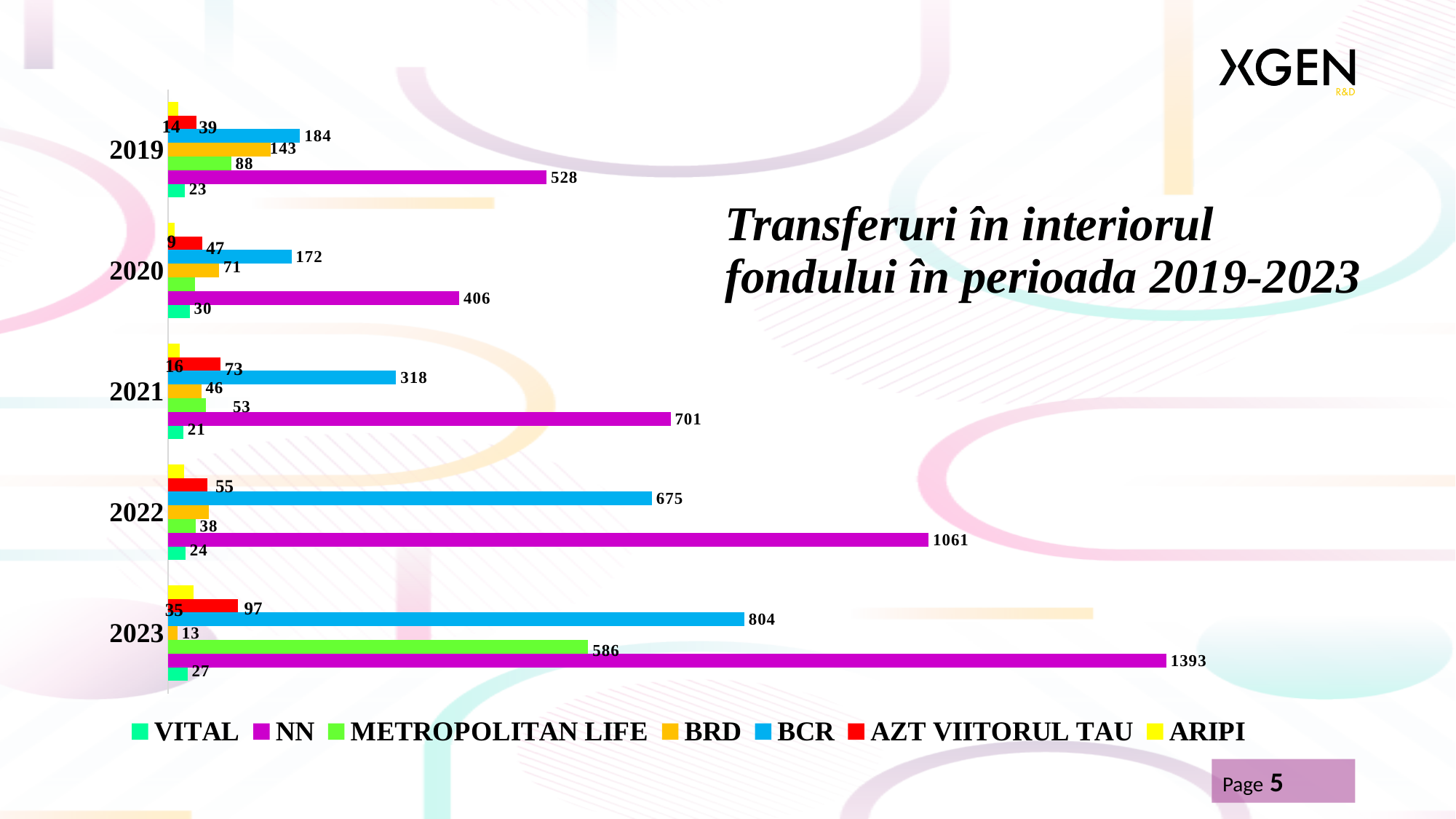
In which year is the NN value highest? 2023 What is the value for METROPOLITAN LIFE in 2023? 586 How many years are shown on the chart? 5 What is the value for NN in 2023? 1393 What is the value for VITAL in 2020? 30 What is the difference between the NN values for 2023 and 2022? 332 What is the value for BRD in 2019? 143 How many series does the legend list? 7 What is the value for BCR in 2022? 675 In which year is the BRD value lowest? 2023 Does the NN value rise or fall from 2019 to 2023? rise Which is larger in 2023, BCR or METROPOLITAN LIFE? BCR